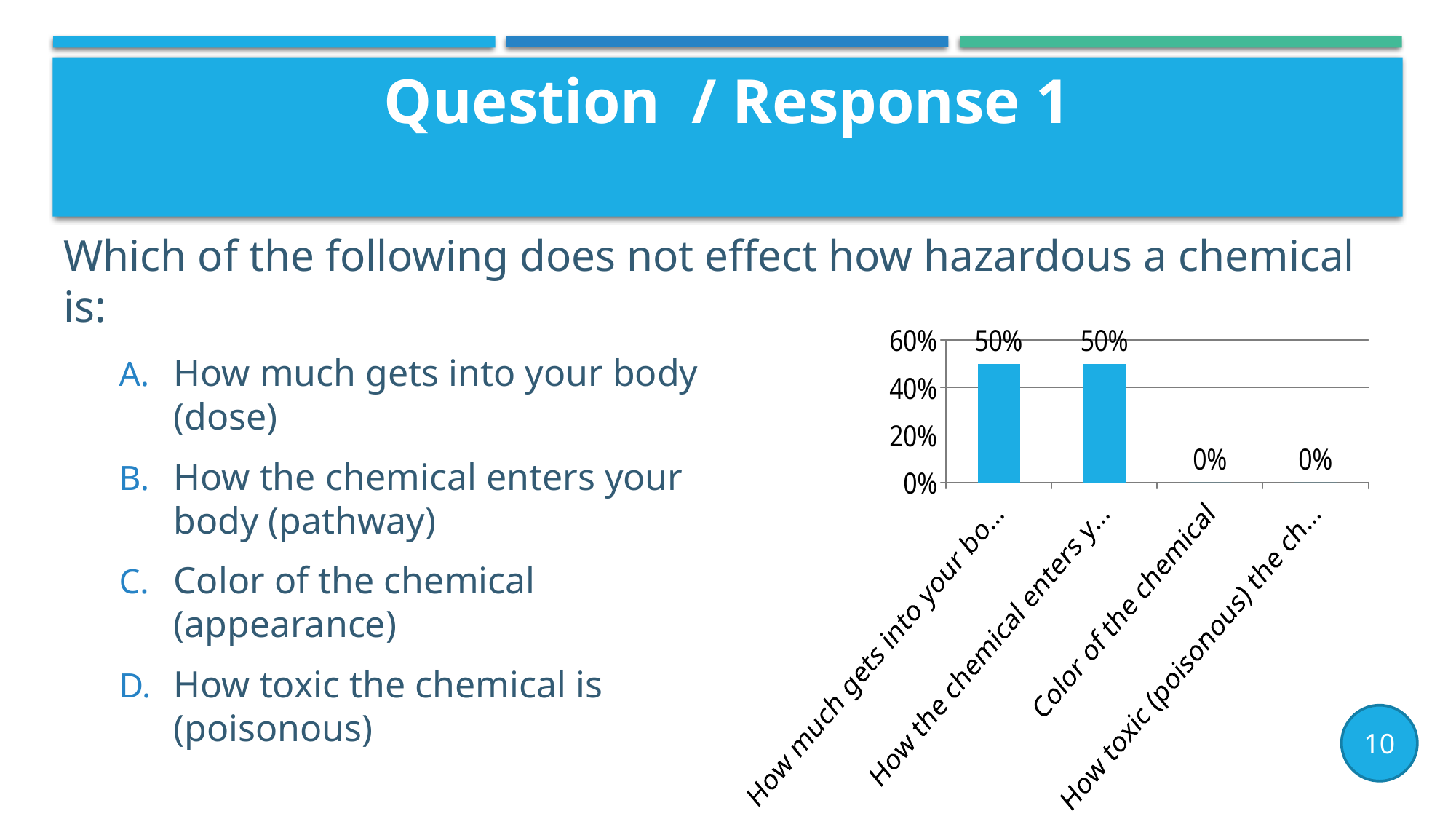
What is the value for "Color of the chemical"? 0% Which is larger, the value for "How the chemical enters y..." or the value for "How toxic (poisonous) the ch..."? How the chemical enters y... What colour are the bars in the chart? blue What is the value for the first category, "How much gets into your bo..."? 50% What is the value for "How the chemical enters y..."? 50% What kind of chart is shown on the slide? bar chart What is the difference between the value for "How much gets into your bo..." and the value for "Color of the chemical"? 50% How many categories are shown on the x axis of the chart? 4 What is the highest value shown on the y axis of the chart? 60% What is the value for "How toxic (poisonous) the ch..."? 0% Is the value for "How much gets into your bo..." greater or less than 40%? greater How many categories have a value of 0%? 2